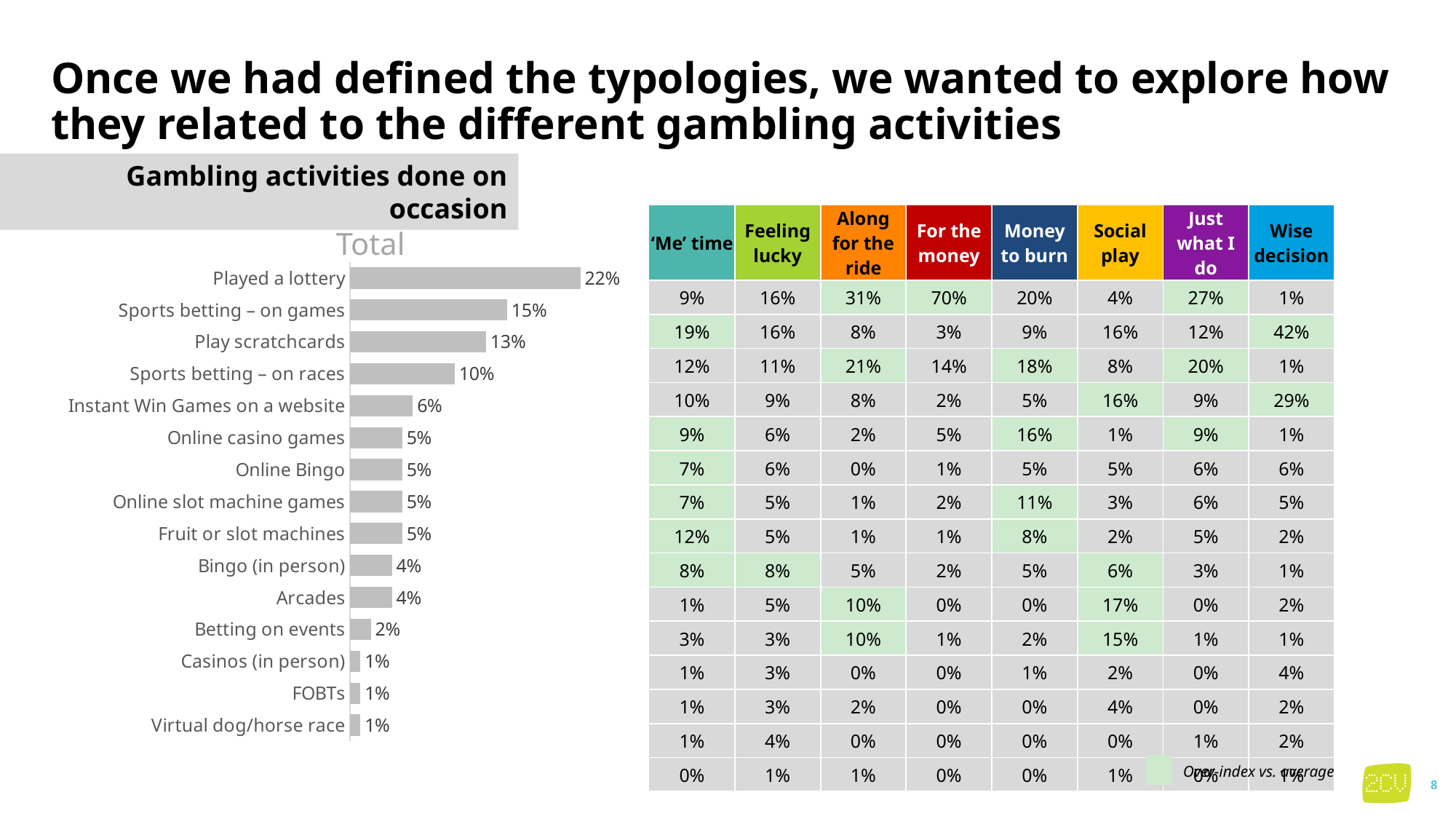
What is the value for Play scratchcards? 13% What is the value for Played a lottery in the Total chart? 22% What value is shown for Instant Win Games on a website? 6% Which is larger, the value for Play scratchcards or the value for Sports betting – on races? Play scratchcards What kind of chart is used to show the gambling activities done on occasion? Bar chart What percentage is shown for Sports betting – on games? 15% What is the difference between Sports betting – on races and Bingo (in person)? 6% What is the difference between the values for Played a lottery and Sports betting – on games? 7% What is the value for Betting on events? 2% Which gambling activity has the highest value in the Total chart? Played a lottery How many gambling activities are listed in the Total bar chart? 15 What is the title shown directly above the bar chart? Total